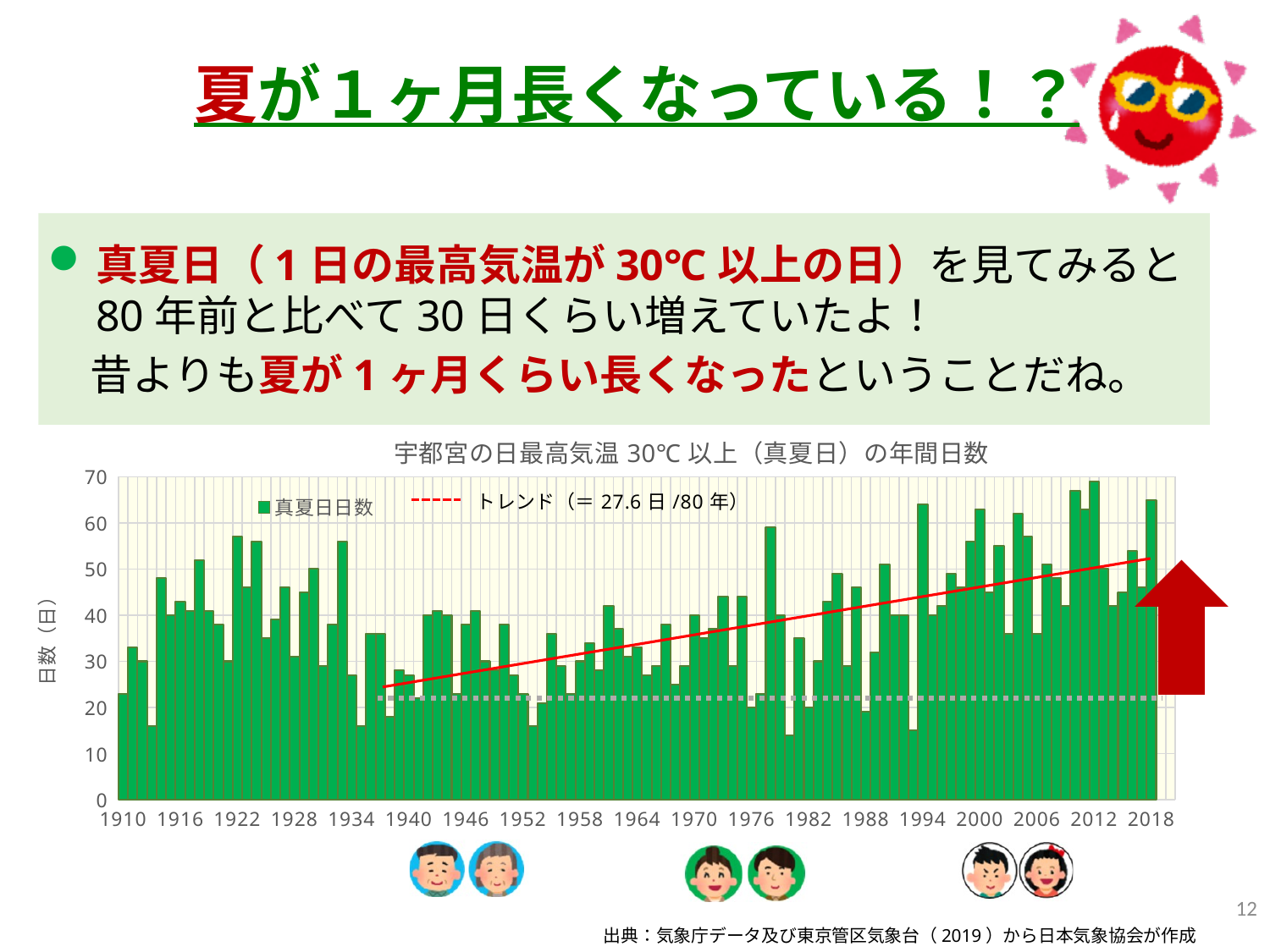
2000年の真夏日日数は50日より多いですか、少ないですか？ 多い 2018年の真夏日日数は60日より多いですか、少ないですか？ 多い 2018年の真夏日日数は1910年より多いですか、少ないですか？ 多い 1922年の真夏日日数は50日より多いですか、少ないですか？ 多い このグラフはどの種類のグラフですか？ 棒グラフ 凡例にはいくつの系列が示されていますか？ 2 凡例に示されているトレンドの値はいくらですか？ 27.6日/80年 1910年から2018年にかけて、真夏日日数は全体として増加していますか、減少していますか？ 増加 グラフのタイトルは何ですか？ 宇都宮の日最高気温30℃以上（真夏日）の年間日数